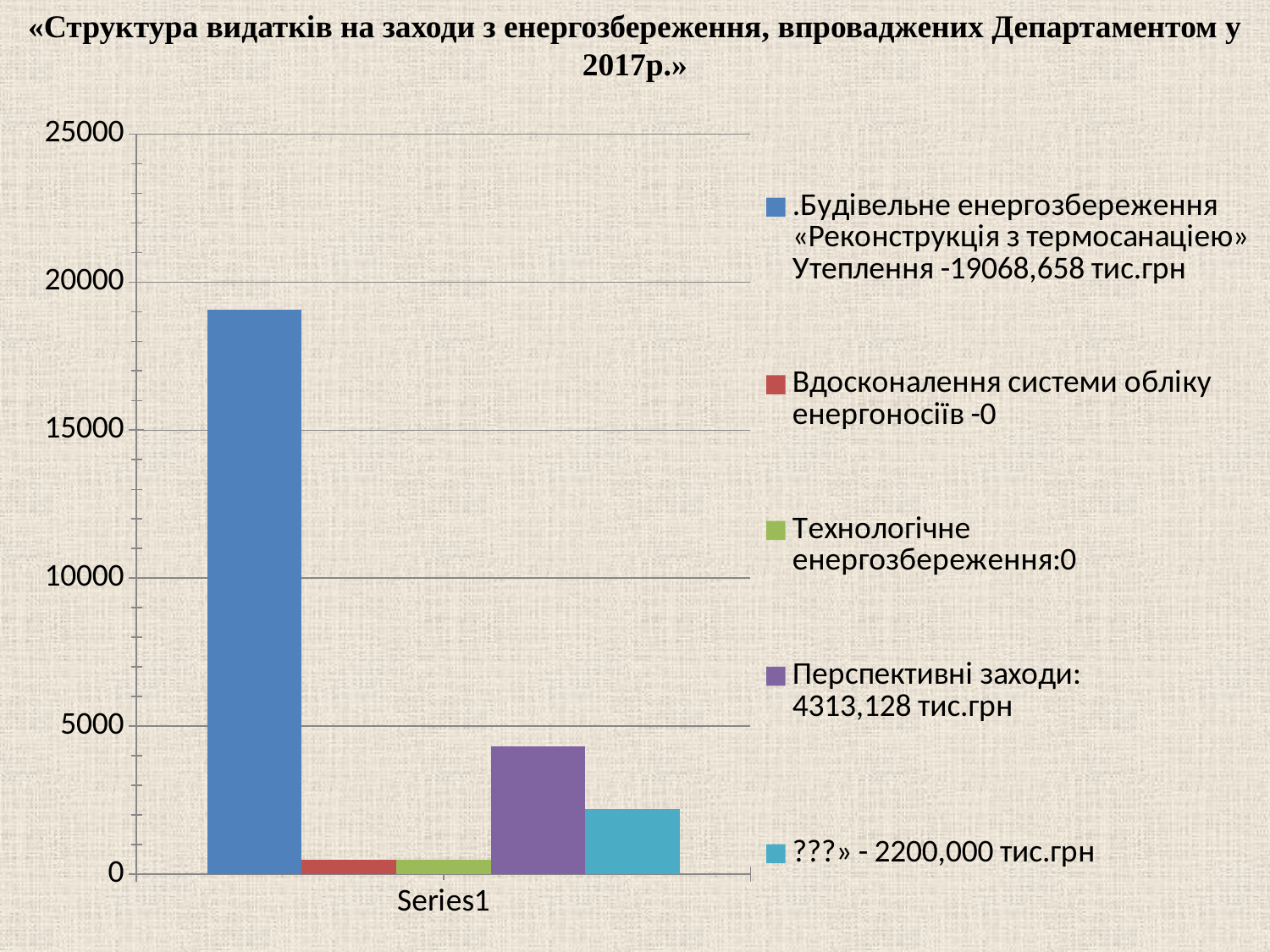
What is the category label shown on the x axis? Series1 Is the value for Перспективні заходи (the purple bar) greater or less than 5000? less Which is larger: the bar for Перспективні заходи or the bar for «???»? Перспективні заходи How many series does the legend list? 5 Which series has the tallest bar? Будівельне енергозбереження «Реконструкція з термосанацією» Утеплення How many bars are plotted in the chart? 5 What type of chart is shown on the slide? bar chart According to the legend, what amount is given for Будівельне енергозбереження «Реконструкція з термосанацією» Утеплення? 19068,658 тис.грн Is the value for Будівельне енергозбереження (the blue bar) greater or less than 15000? greater According to the legend, what amount is given for Перспективні заходи? 4313,128 тис.грн What is the highest value shown on the y axis? 25000 According to the legend, what amount is given for the «???» series? 2200,000 тис.грн